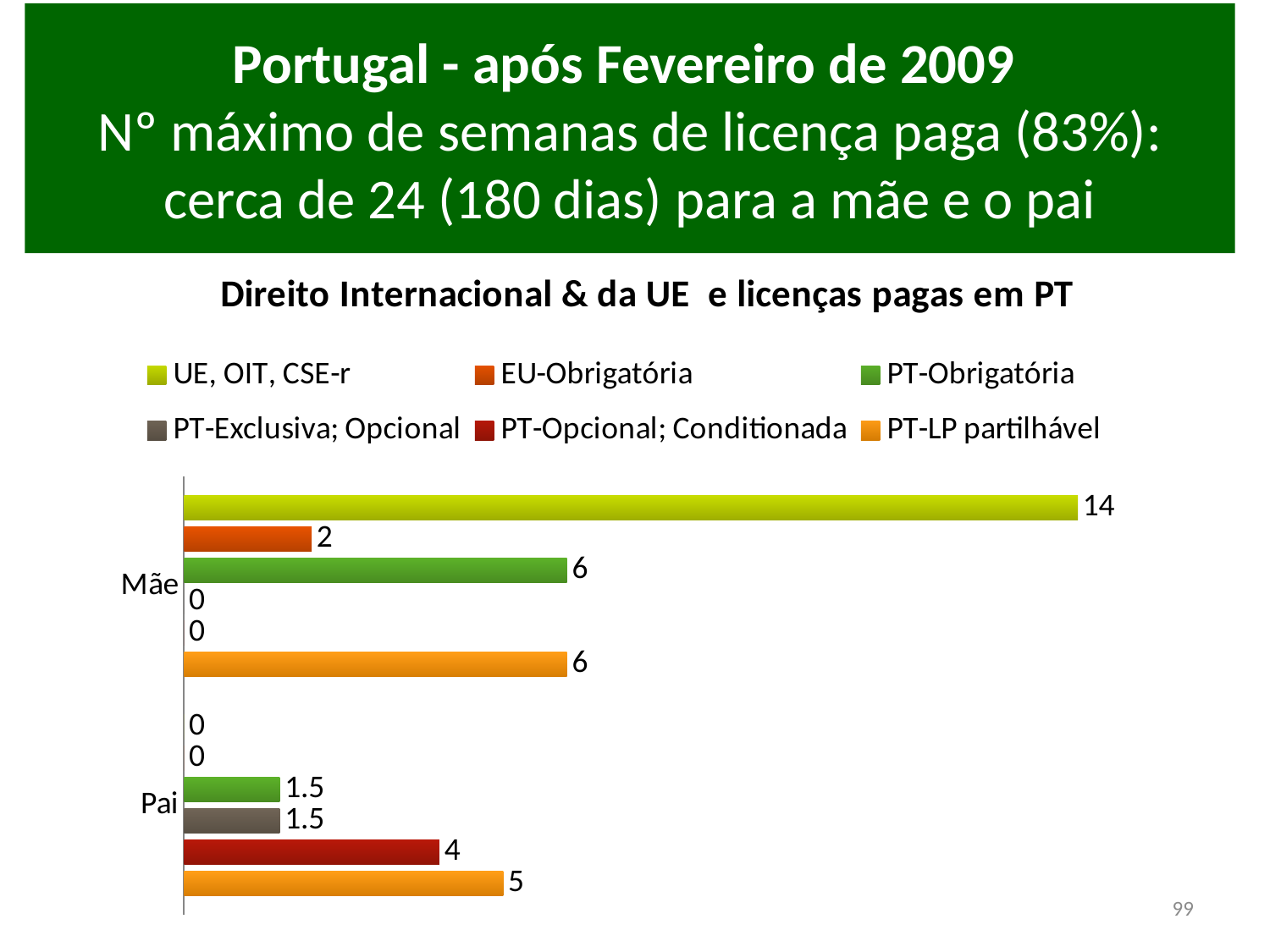
How many categories are shown on the vertical axis? 2 What is the value of the PT-LP partilhável series for Pai? 5 What is the value of the EU-Obrigatória series for Mãe? 2 What is the value of the PT-Opcional; Condicionada series for Pai? 4 What is the value of the UE, OIT, CSE-r series for Mãe? 14 What is the difference between the UE, OIT, CSE-r value and the PT-Obrigatória value for Mãe? 8 What type of chart is shown on the slide? Bar chart How many series does the legend list? 6 Which series has the highest value for Mãe? UE, OIT, CSE-r Which is larger for Pai: PT-Opcional; Condicionada or PT-LP partilhável? PT-LP partilhável What is the value of the PT-Obrigatória series for Pai? 1.5 Which series has the highest value for Pai? PT-LP partilhável